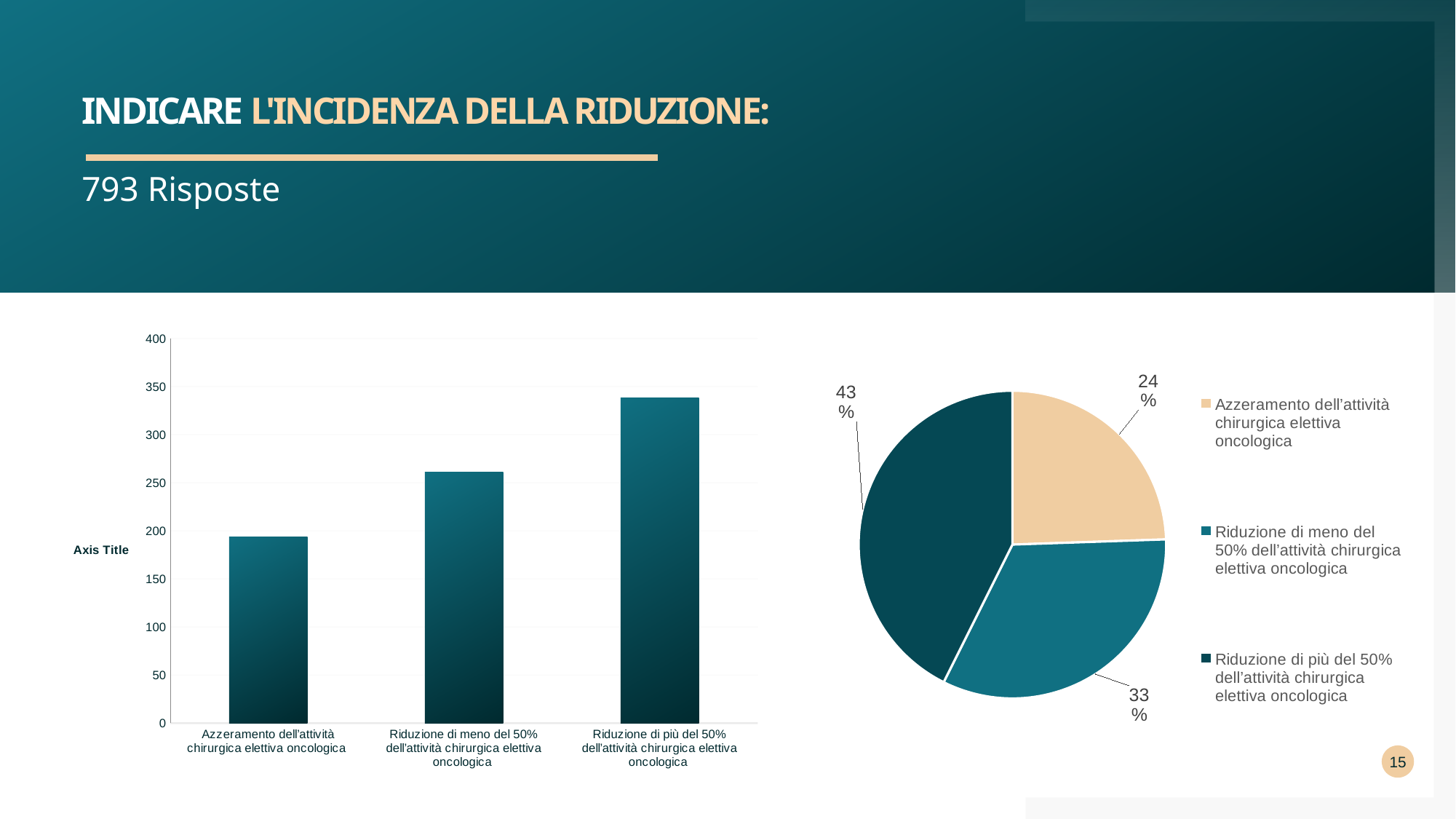
In the bar chart on the left, do the bar values rise or fall from left to right? Rise In the bar chart on the left, which category has the highest bar? Riduzione di più del 50% dell'attività chirurgica elettiva oncologica In the pie chart on the right, what share is shown for Azzeramento dell'attività chirurgica elettiva oncologica? 24% In the bar chart on the left, is the value for Azzeramento dell'attività chirurgica elettiva oncologica greater or less than 150? greater What kind of chart is the chart on the right of the slide? Pie chart What kind of chart is the chart on the left of the slide? Bar chart In the bar chart on the left, is the value for Riduzione di più del 50% dell'attività chirurgica elettiva oncologica greater or less than 300? greater In the pie chart on the right, how many entries does the legend list? 3 In the bar chart on the left, how many categories are shown? 3 In the pie chart on the right, what share is shown for Riduzione di più del 50% dell'attività chirurgica elettiva oncologica? 43% In the bar chart on the left, which category has the lowest bar? Azzeramento dell'attività chirurgica elettiva oncologica In the bar chart on the left, is the value for Riduzione di meno del 50% dell'attività chirurgica elettiva oncologica greater or less than 300? less